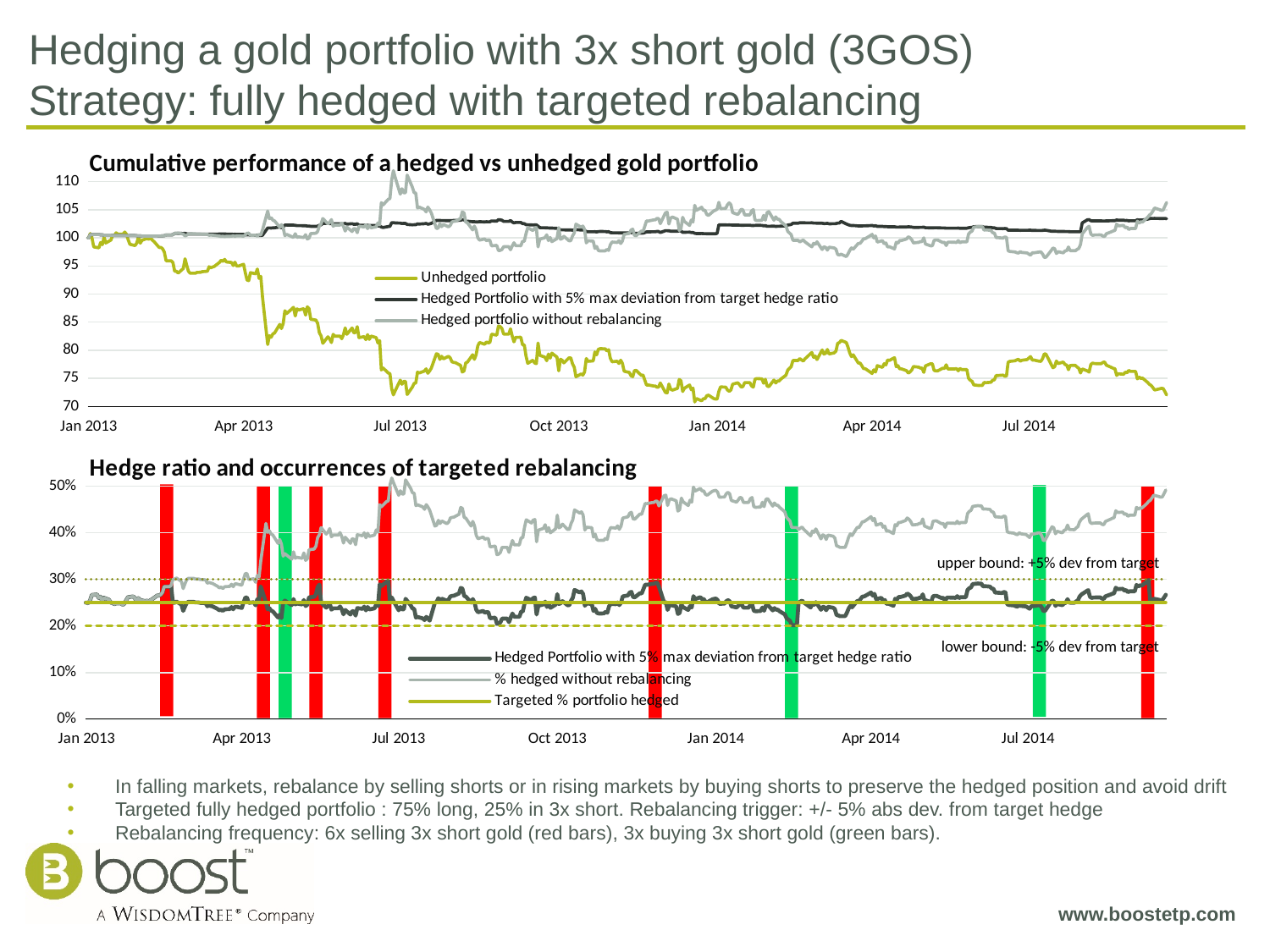
How many series does the legend of the top chart list? 3 In the bottom chart, how many red bars (selling 3x short gold) are shown? 6 In the bottom chart, how many green bars (buying 3x short gold) are shown? 3 In the top chart, does the Unhedged portfolio generally rise or fall from Jan 2013 to Jul 2014? fall In the top chart, which series is lowest at Jan 2014: the Unhedged portfolio or the Hedged Portfolio with 5% max deviation from target hedge ratio? Unhedged portfolio In the top chart, is the 'Hedged Portfolio with 5% max deviation from target hedge ratio' at the end of the series greater or less than 100? greater In the top chart, is the value of the Unhedged portfolio at the end of the series (after Jul 2014) greater or less than 75? less In the bottom chart 'Hedge ratio and occurrences of targeted rebalancing', what is the value of the Targeted % portfolio hedged line? 25% What type of chart is the top chart titled 'Cumulative performance of a hedged vs unhedged gold portfolio'? line chart In the bottom chart, at what level is the upper bound (+5% dev from target) drawn? 30% In the bottom chart, is the '% hedged without rebalancing' series at the end of the period greater or less than 40%? greater